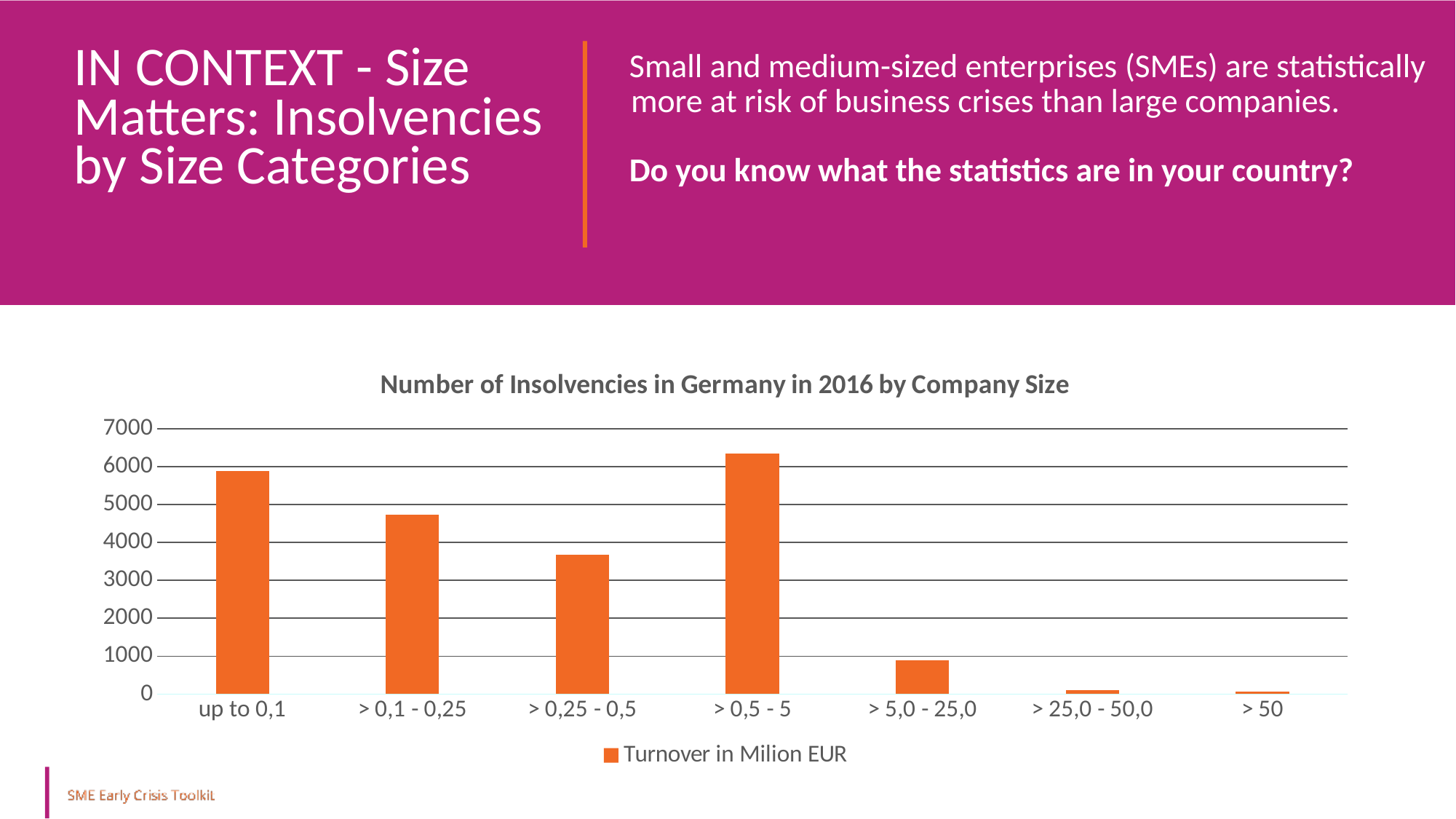
What is the series name shown in the chart legend? Turnover in Milion EUR How many series does the chart legend list? 1 Is the value for the '> 0,25 - 0,5' category greater or less than 3000? greater What kind of chart is shown on the slide? bar chart Is the value for the '> 0,5 - 5' category greater or less than 6000? greater How many company size categories are shown on the x axis of the chart? 7 Which has the larger value: 'up to 0,1' or '> 0,1 - 0,25'? up to 0,1 Which company size category has the highest number of insolvencies? > 0,5 - 5 Is the value for the 'up to 0,1' category greater or less than 5000? greater What is the title of the chart? Number of Insolvencies in Germany in 2016 by Company Size